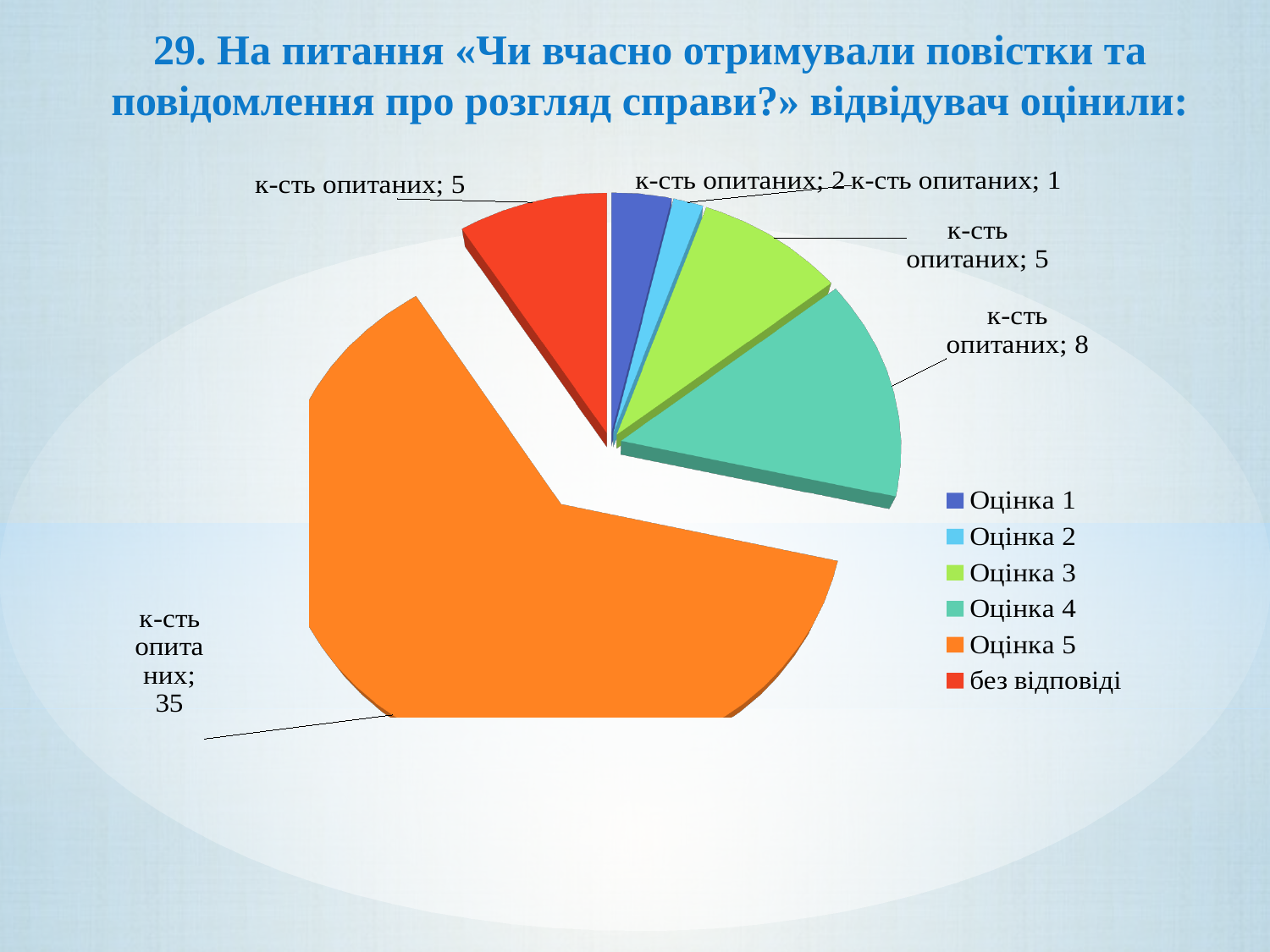
Which category has the smallest slice of the pie? Оцінка 2 Which category has the largest slice of the pie? Оцінка 5 What is the difference between the number of respondents for Оцінка 5 and Оцінка 4? 27 How many respondents are in the 'без відповіді' category? 5 What kind of chart is shown on the slide? pie chart How many categories does the legend of the pie chart list? 6 How many respondents gave Оцінка 3? 5 How many respondents (к-сть опитаних) gave Оцінка 5? 35 What colour is the Оцінка 5 slice in the pie chart? orange How many respondents gave Оцінка 4? 8 What is the total number of respondents across all slices of the pie? 56 Which has more respondents, Оцінка 4 or Оцінка 3? Оцінка 4